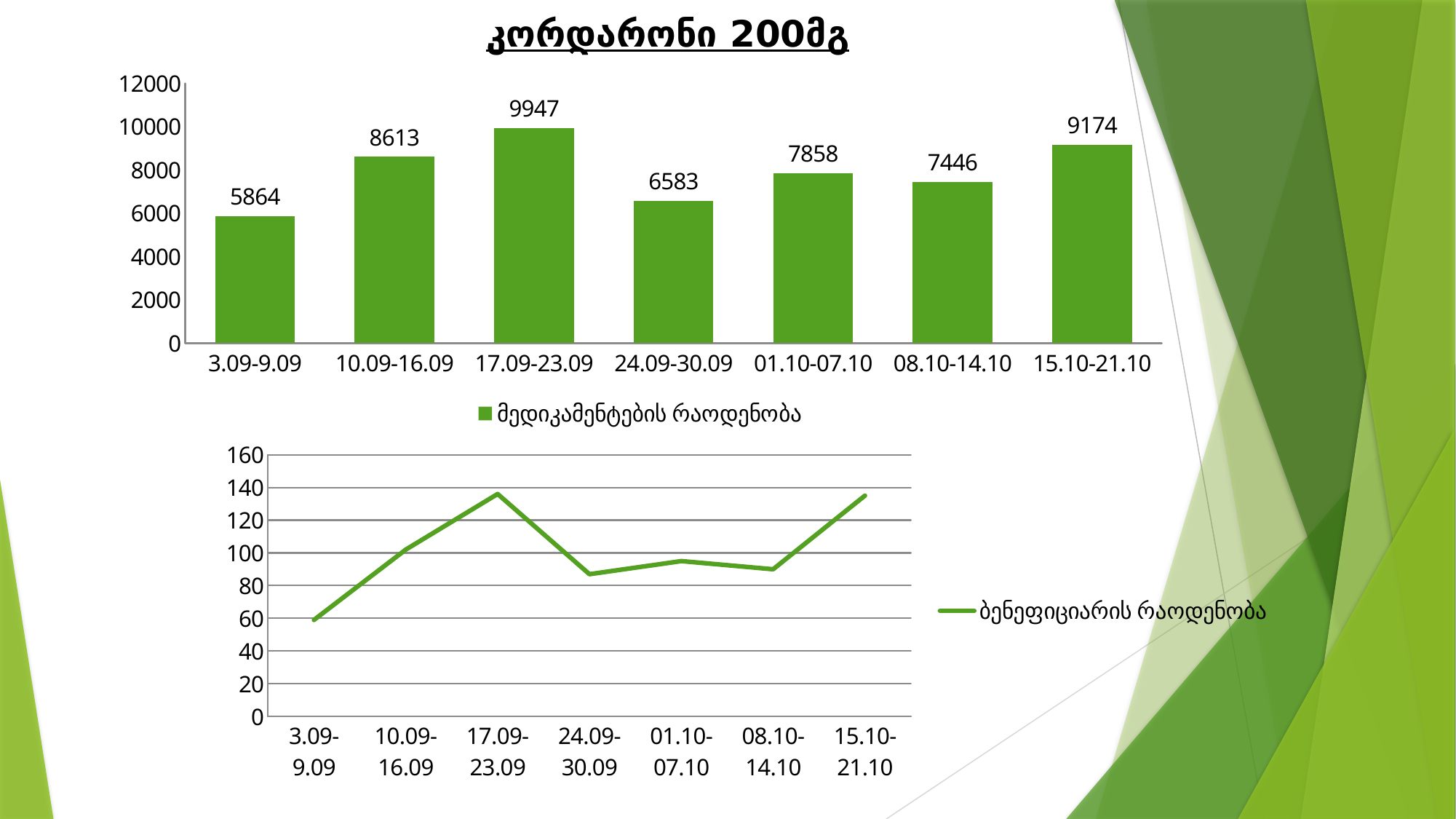
In the top bar chart, what is the value for 08.10-14.10? 7446 What kind of chart is the bottom chart on the slide? Line chart In the top bar chart, what is the value for 3.09-9.09? 5864 In the bottom line chart, is the value for 3.09-9.09 greater or less than 80? less In the top bar chart, what is the difference between the values for 15.10-21.10 and 24.09-30.09? 2591 In the top bar chart, which is larger: the value for 10.09-16.09 or the value for 01.10-07.10? 10.09-16.09 In the bottom line chart, is the value for 17.09-23.09 greater or less than 120? greater How many periods are shown on the x axis of the top bar chart? 7 In the top bar chart, what is the value for 17.09-23.09? 9947 In the top bar chart, which period has the highest value? 17.09-23.09 What is the title of the top bar chart? კორდარონი 200მგ In the top bar chart, which period has the lowest value? 3.09-9.09